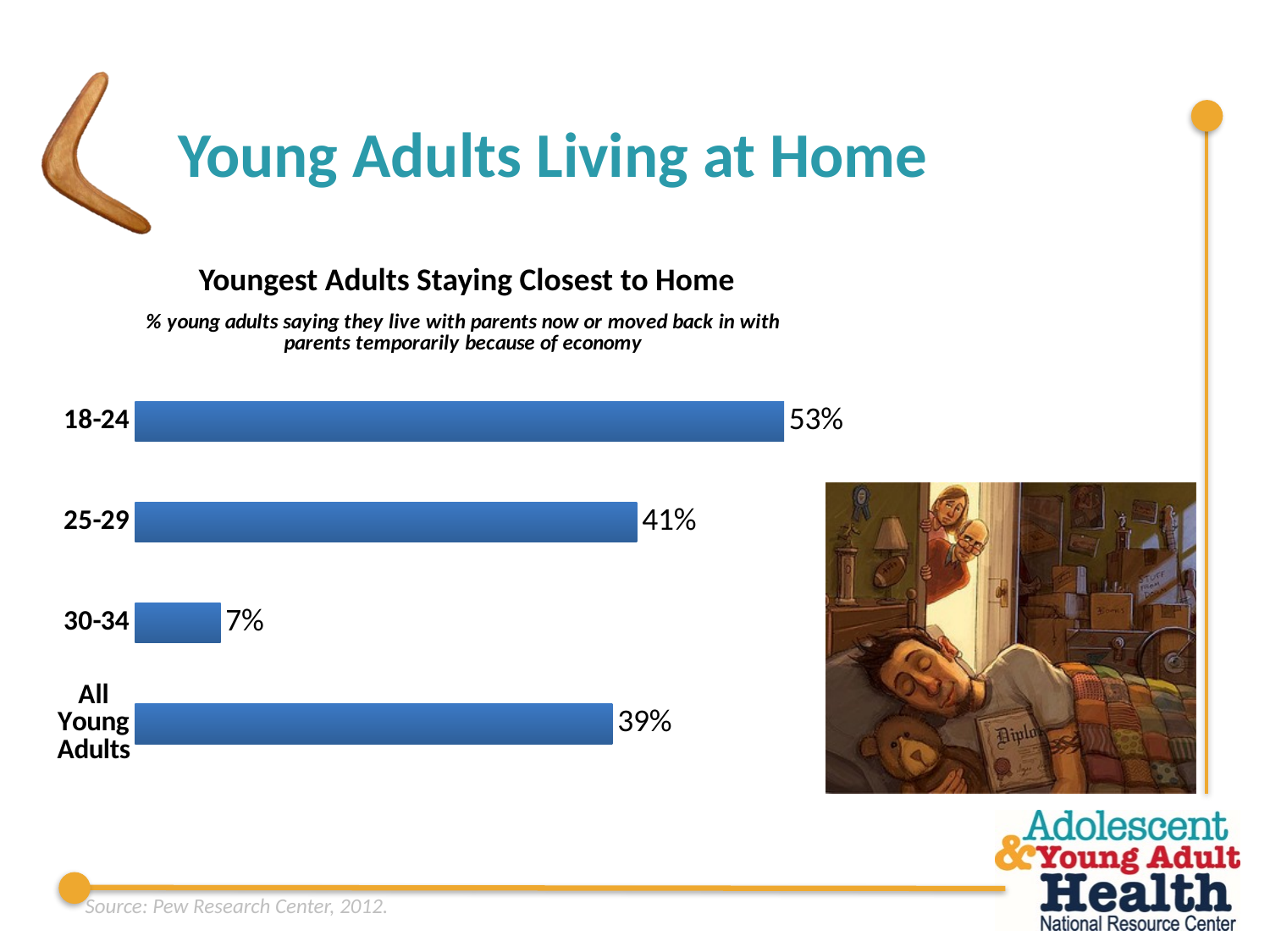
Which is larger, the value for 25-29 or the value for All Young Adults? 25-29 Which age group has the highest percentage living with parents? 18-24 What is the title of the chart? Youngest Adults Staying Closest to Home What is the difference between the values for 25-29 and 30-34? 34% What is the value shown for the 25-29 age group? 41% What is the value shown for the 30-34 age group? 7% What kind of chart is shown on the slide? Bar chart What is the difference between the values for 18-24 and 25-29? 12% What percentage of 18-24 year olds say they live with parents now or moved back in temporarily? 53% Which category has the lowest value on the chart? 30-34 How many categories are shown on the chart? 4 What is the value shown for All Young Adults? 39%